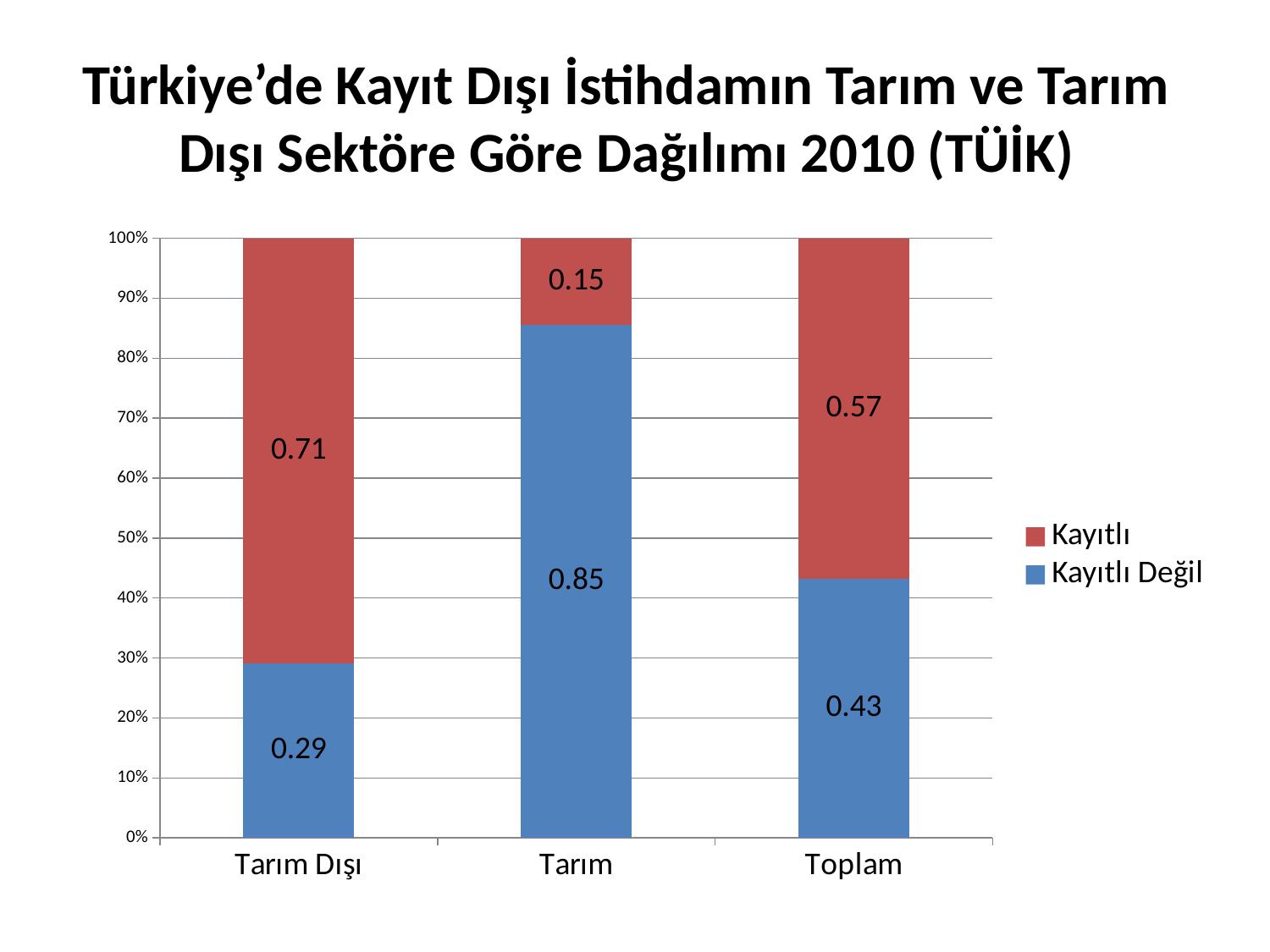
What is the value of Kayıtlı for Tarım? 0.15 What kind of chart is shown on the slide? Stacked bar chart How many categories are shown on the x axis? 3 What is the value of Kayıtlı Değil for Tarım? 0.85 What is the difference between the Kayıtlı Değil values for Tarım and Tarım Dışı? 0.56 Which colour represents the Kayıtlı series in the legend? Red Which category has the highest Kayıtlı Değil value? Tarım What is the value of Kayıtlı Değil for Toplam? 0.43 Which category has the lowest Kayıtlı value? Tarım How many series does the legend list? 2 What is the value of Kayıtlı for Tarım Dışı? 0.71 Which is larger: the Kayıtlı value for Toplam or the Kayıtlı value for Tarım Dışı? Tarım Dışı